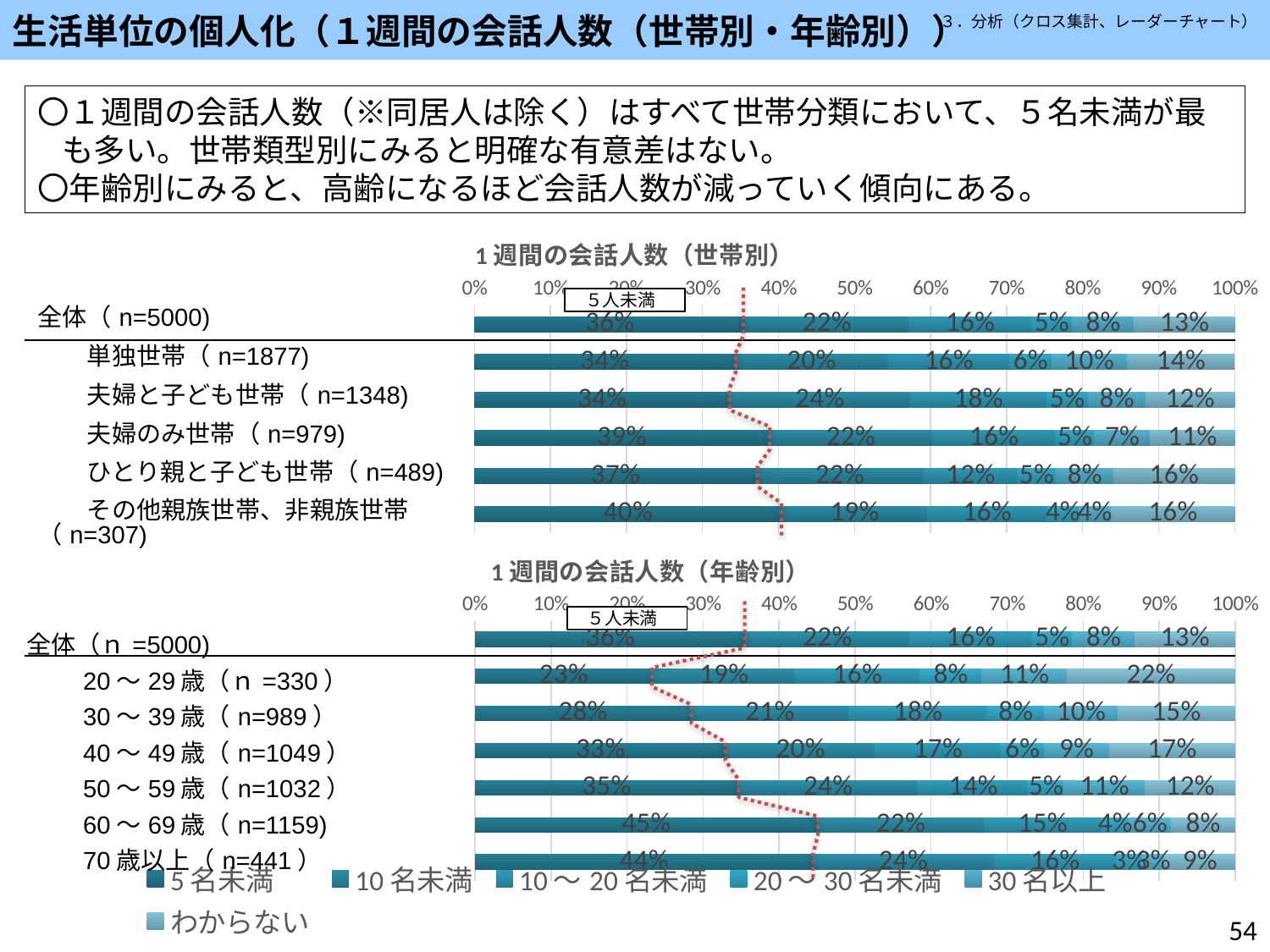
In the chart titled 1週間の会話人数（年齢別）, what is the わからない value for 60～69歳? 8% In the chart titled 1週間の会話人数（年齢別）, which age group has the lowest 5名未満 value? 20～29歳 In the chart titled 1週間の会話人数（世帯別）, what is the わからない value for 単独世帯? 14% What type of chart is used for 1週間の会話人数（世帯別）? stacked horizontal bar chart In the chart titled 1週間の会話人数（世帯別）, what is the 5名未満 value for 夫婦のみ世帯? 39% In the chart titled 1週間の会話人数（世帯別）, which household category has the highest 5名未満 value? その他親族世帯、非親族世帯 In the chart titled 1週間の会話人数（世帯別）, how many household categories (bars) are shown, including 全体? 6 In the chart titled 1週間の会話人数（年齢別）, what is the 5名未満 value for 20～29歳? 23% In the chart titled 1週間の会話人数（年齢別）, which is larger, the 10名未満 value for 50～59歳 or for 30～39歳? 50～59歳 In the chart titled 1週間の会話人数（年齢別）, does the 5名未満 share generally rise or fall as the age groups go from 20～29歳 to 60～69歳? rise How many series does the legend at the bottom of the slide list? 6 In the chart titled 1週間の会話人数（世帯別）, what is the difference between the 5名未満 values for 夫婦のみ世帯 and 単独世帯? 5%